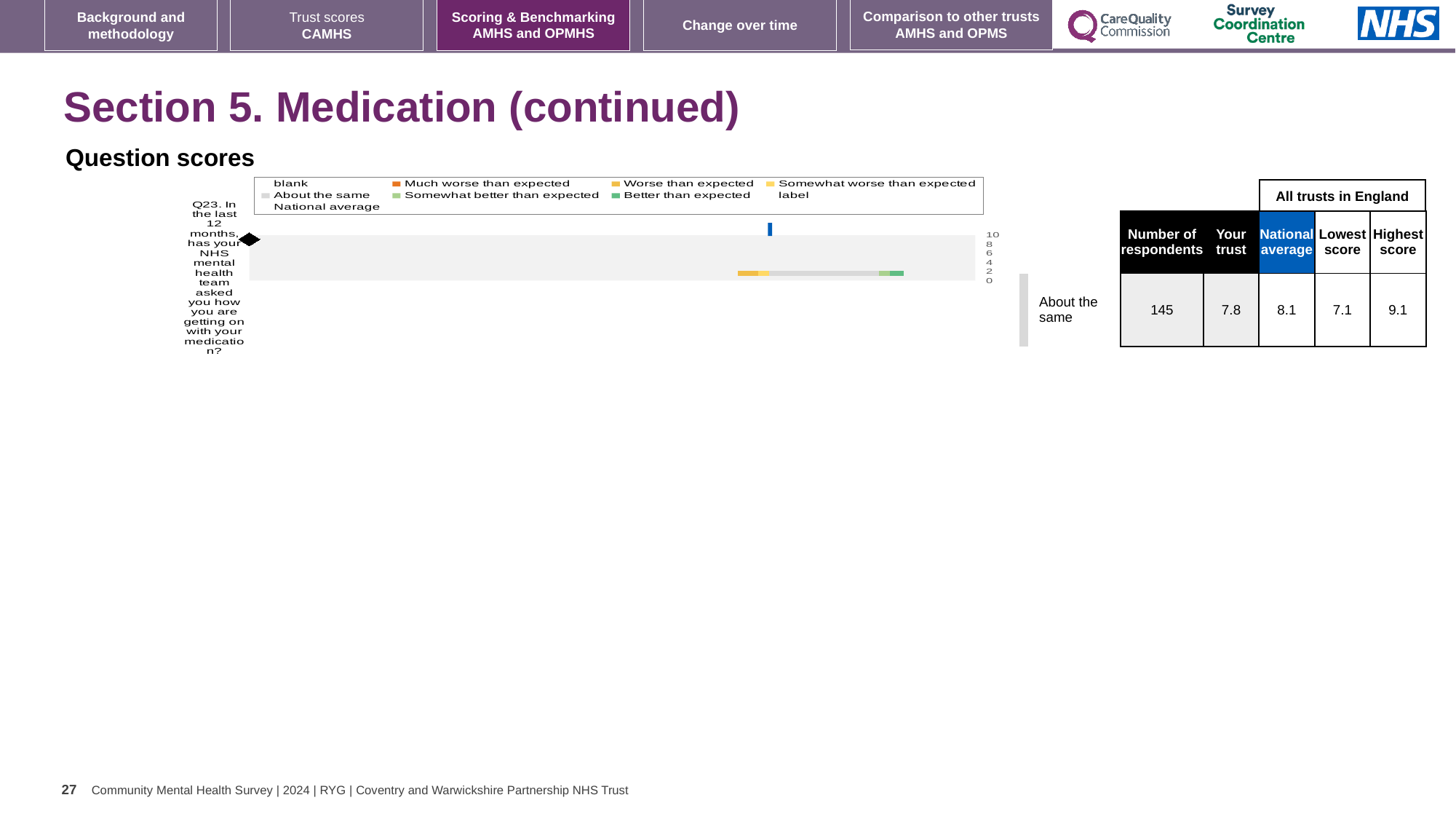
How many questions (categories) are plotted in the chart? 1 Which question number is plotted in the chart? Q23 In the table beside the chart, what is the lowest score among all trusts in England for Q23? 7.1 In the table beside the chart, how many respondents answered Q23? 145 In the table beside the chart, what is the 'Your trust' score for Q23? 7.8 Which is larger for Q23, the 'Your trust' score or the national average? National average What is the difference between the highest score and the lowest score for Q23 in the table? 2.0 In the table beside the chart, what is the highest score among all trusts in England for Q23? 9.1 What kind of chart is shown under 'Question scores'? bar chart What is the maximum value shown on the chart's score axis? 10 In the table beside the chart, what is the national average score for Q23? 8.1 According to the label beside the chart, how does the trust's result for Q23 compare with what was expected? About the same